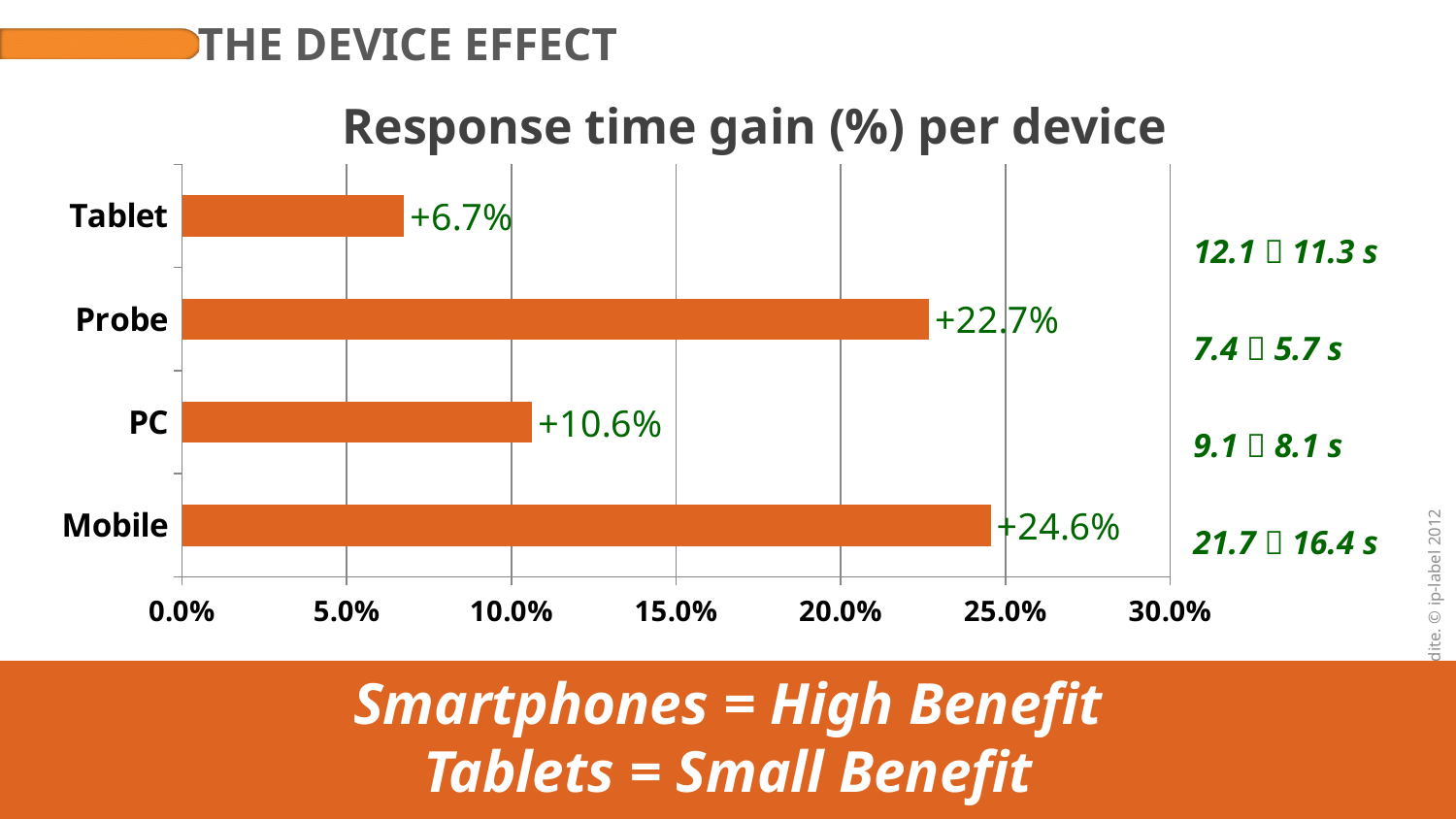
What type of chart is shown on the slide? Bar chart How many devices are shown in the chart? 4 What is the response time gain for Mobile? +24.6% What is the difference between the response time gain for Probe and for PC? 12.1% Which device has the highest response time gain? Mobile Is the response time gain for Probe greater or less than 20.0%? greater Which has a larger response time gain, PC or Tablet? PC Which device has the lowest response time gain? Tablet What is the response time gain for Probe? +22.7% What is the response time gain for Tablet? +6.7% What is the difference between the response time gain for Mobile and for Tablet? 17.9% What is the response time gain for PC? +10.6%